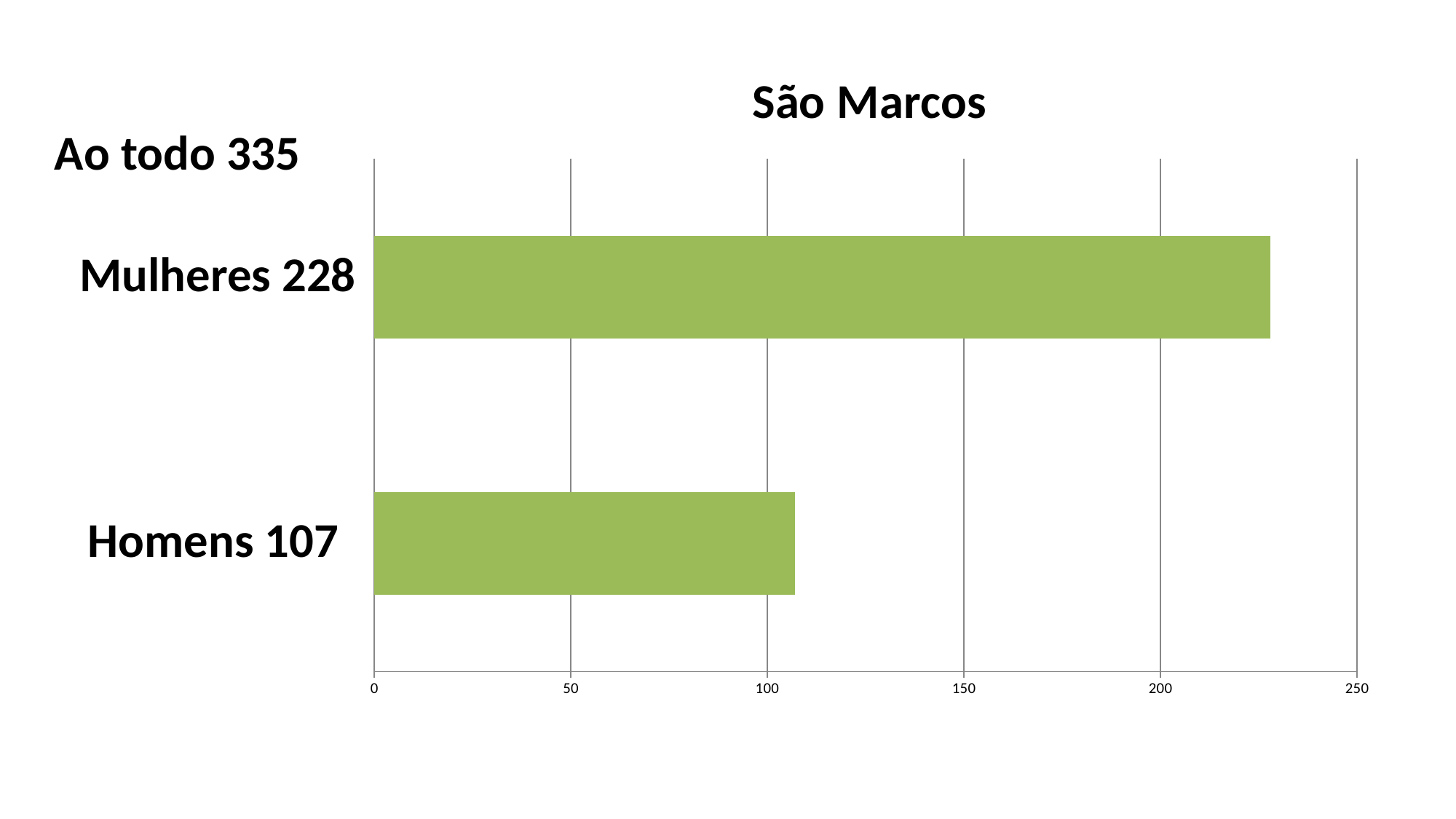
Is the value for Mulheres greater or less than 200? greater What kind of chart is shown on the slide? bar chart What is the difference between the values for Mulheres and Homens? 121 What is the value for Homens? 107 What total is stated on the slide for 'Ao todo'? 335 What is the value for Mulheres? 228 How many categories are shown in the chart? 2 Which is larger, the value for Mulheres or the value for Homens? Mulheres Is the value for Homens greater or less than 150? less Which category has the lowest value? Homens What is the title of the chart? São Marcos Which category has the highest value? Mulheres